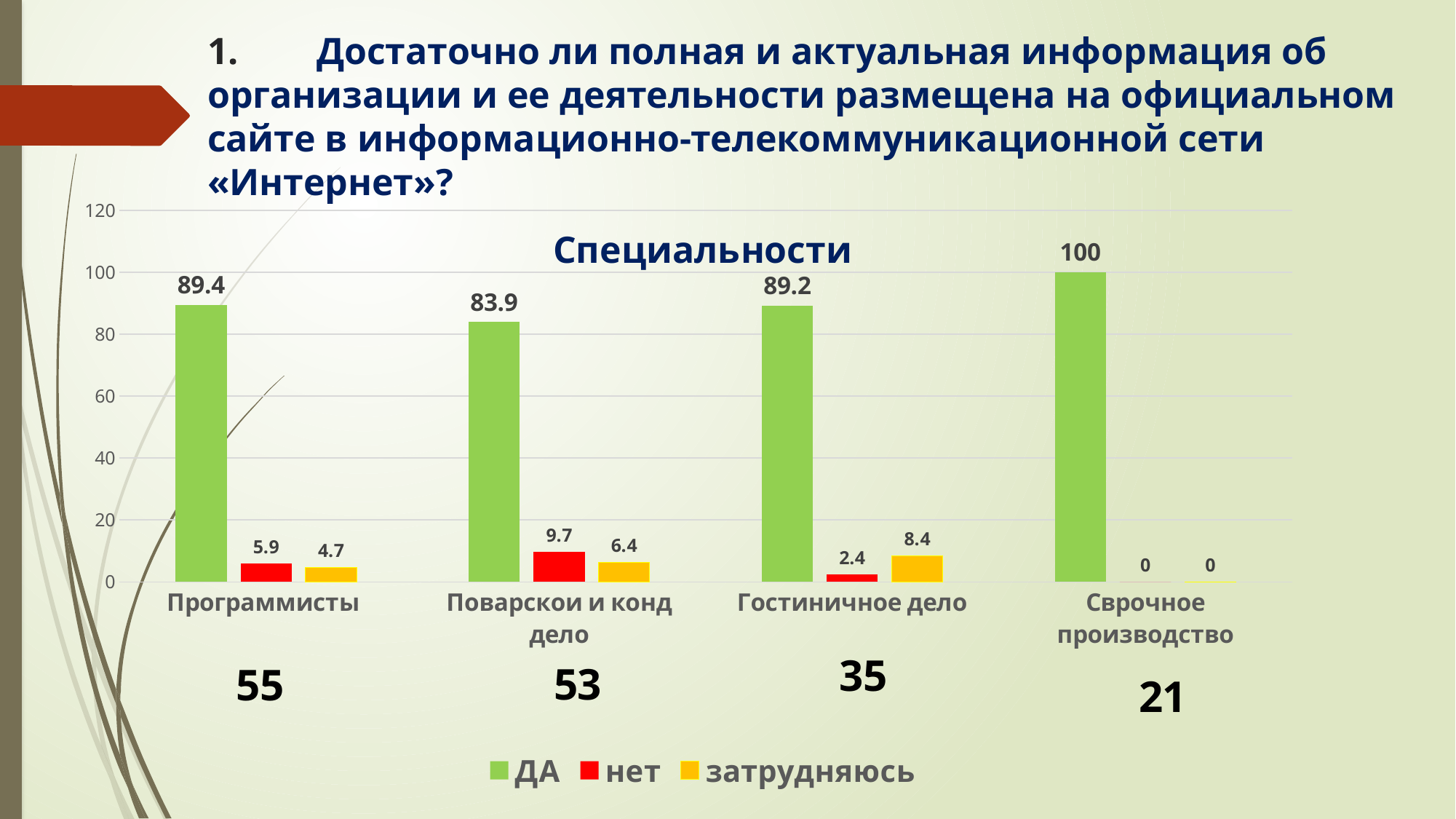
What is the title of the chart? Специальности What is the value of the 'ДА' series for Сврочное производство? 100 Which is larger: the 'затрудняюсь' value for Программисты or for Поварской и конд дело? Поварской и конд дело What is the value of the 'нет' series for Поварской и конд дело? 9.7 Which category has the highest 'ДА' value? Сврочное производство What is the difference between the 'ДА' values for Программисты and Поварской и конд дело? 5.5 What is the value of the 'затрудняюсь' series for Гостиничное дело? 8.4 What is the value of the 'ДА' series for Программисты? 89.4 What kind of chart is shown on the slide? Bar chart How many series does the legend list? 3 How many categories are shown on the x axis? 4 Which category has the lowest 'нет' value? Сврочное производство